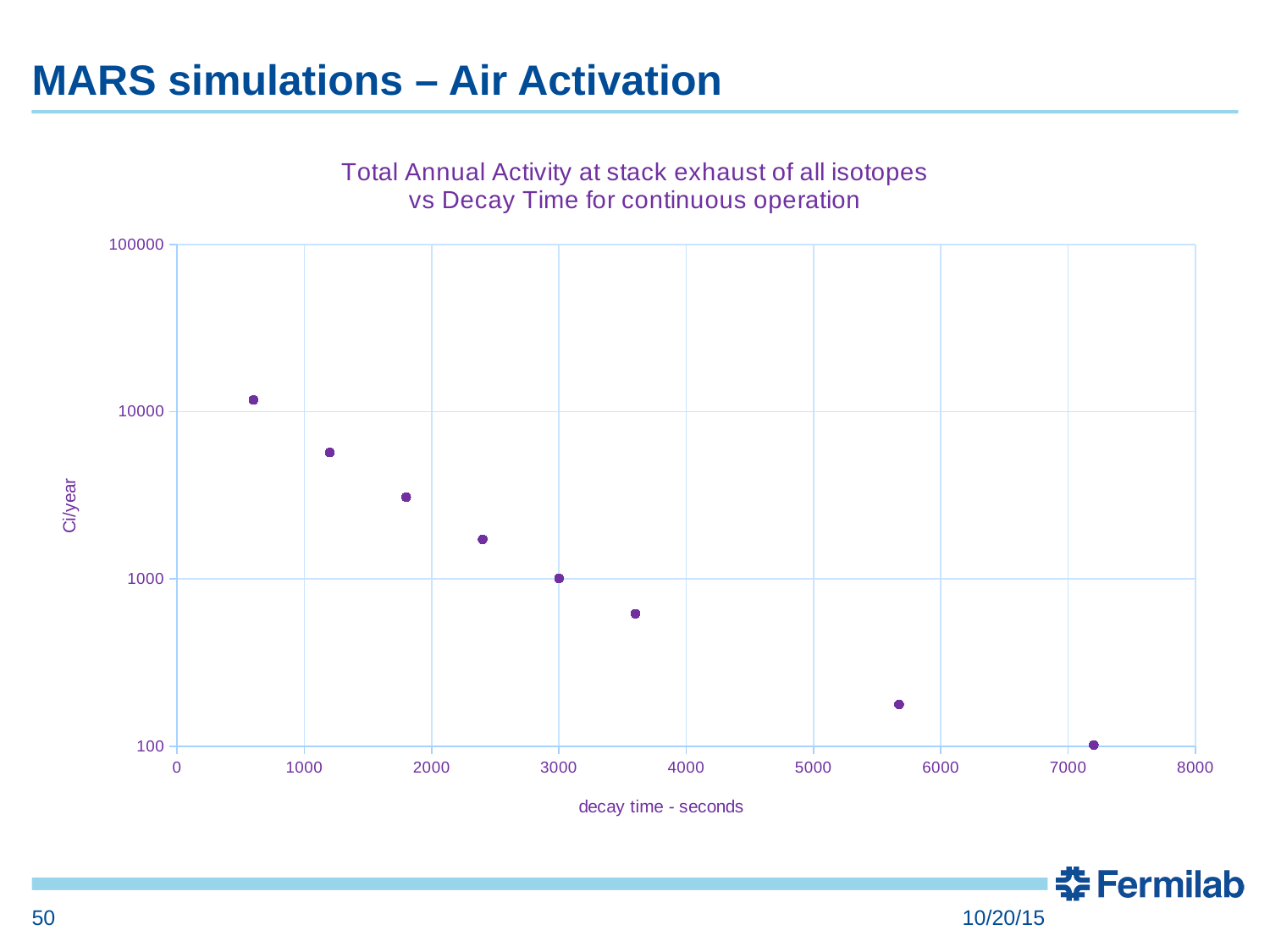
Is the value of the leftmost data point greater or less than 10000 Ci/year? greater Is the value of the data point near 1200 seconds greater or less than 10000 Ci/year? less What kind of chart is shown on the slide? scatter chart What is the label of the x axis? decay time - seconds Do the plotted values rise or fall as decay time increases? fall Is the value of the data point near 5700 seconds greater or less than 1000 Ci/year? less Which data point has the highest Ci/year value, the leftmost or the rightmost? the leftmost What is the title of the chart? Total Annual Activity at stack exhaust of all isotopes vs Decay Time for continuous operation How many data points are plotted on the chart? 8